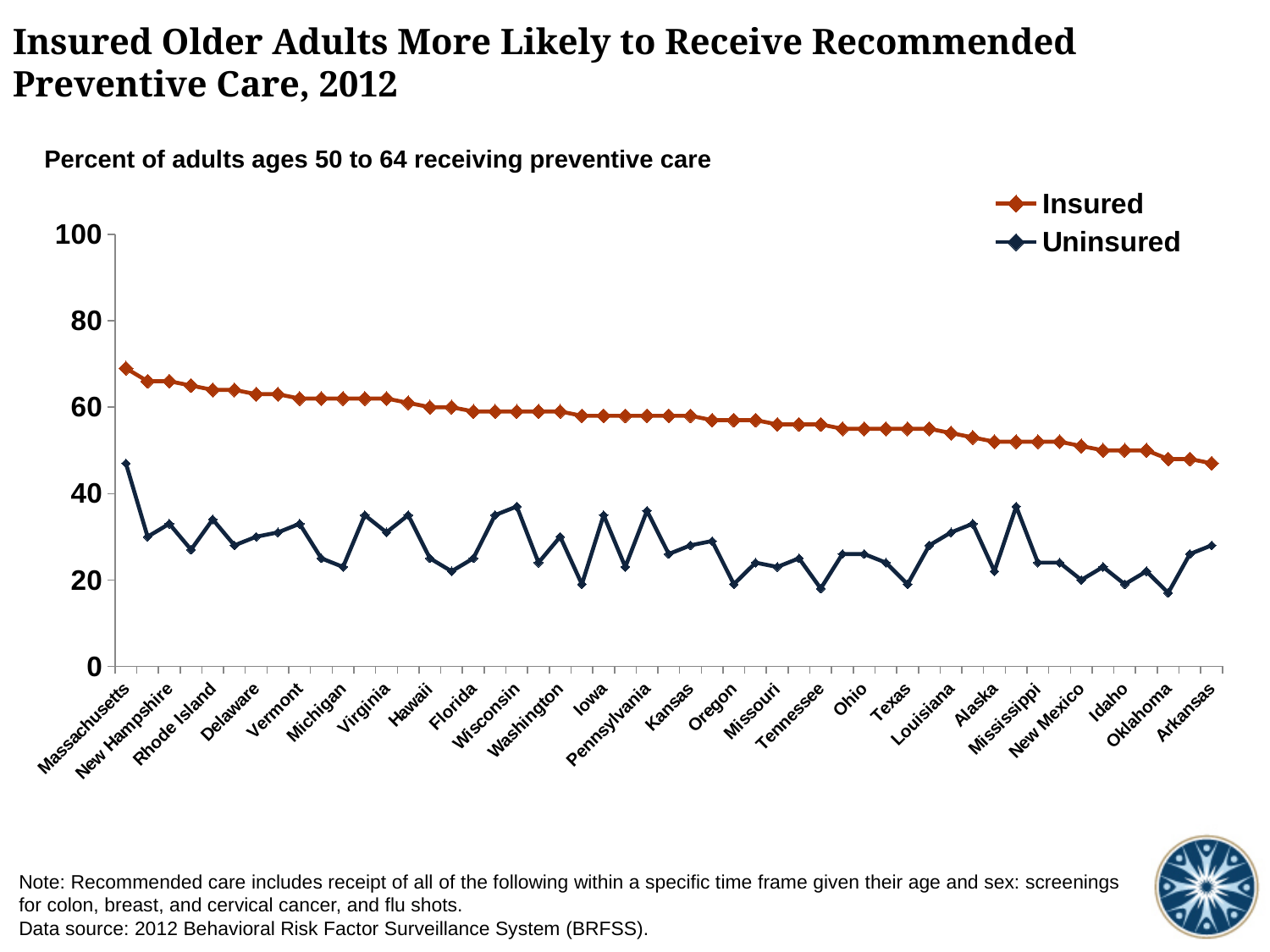
Which two series are shown in the legend? Insured and Uninsured Do the Insured values rise or fall moving from Massachusetts to Arkansas along the x axis? Fall Is the Uninsured value for Massachusetts greater or less than 40? greater Is the Insured value for Ohio greater or less than 60? less Which state has the lowest Insured value? Arkansas Which state has the highest Insured value? Massachusetts Which series is drawn in orange? Insured Is the Insured value for Arkansas greater or less than 60? less What kind of chart is shown on the slide? Line chart For Massachusetts, which is larger: the Insured value or the Uninsured value? Insured How many series does the legend list? 2